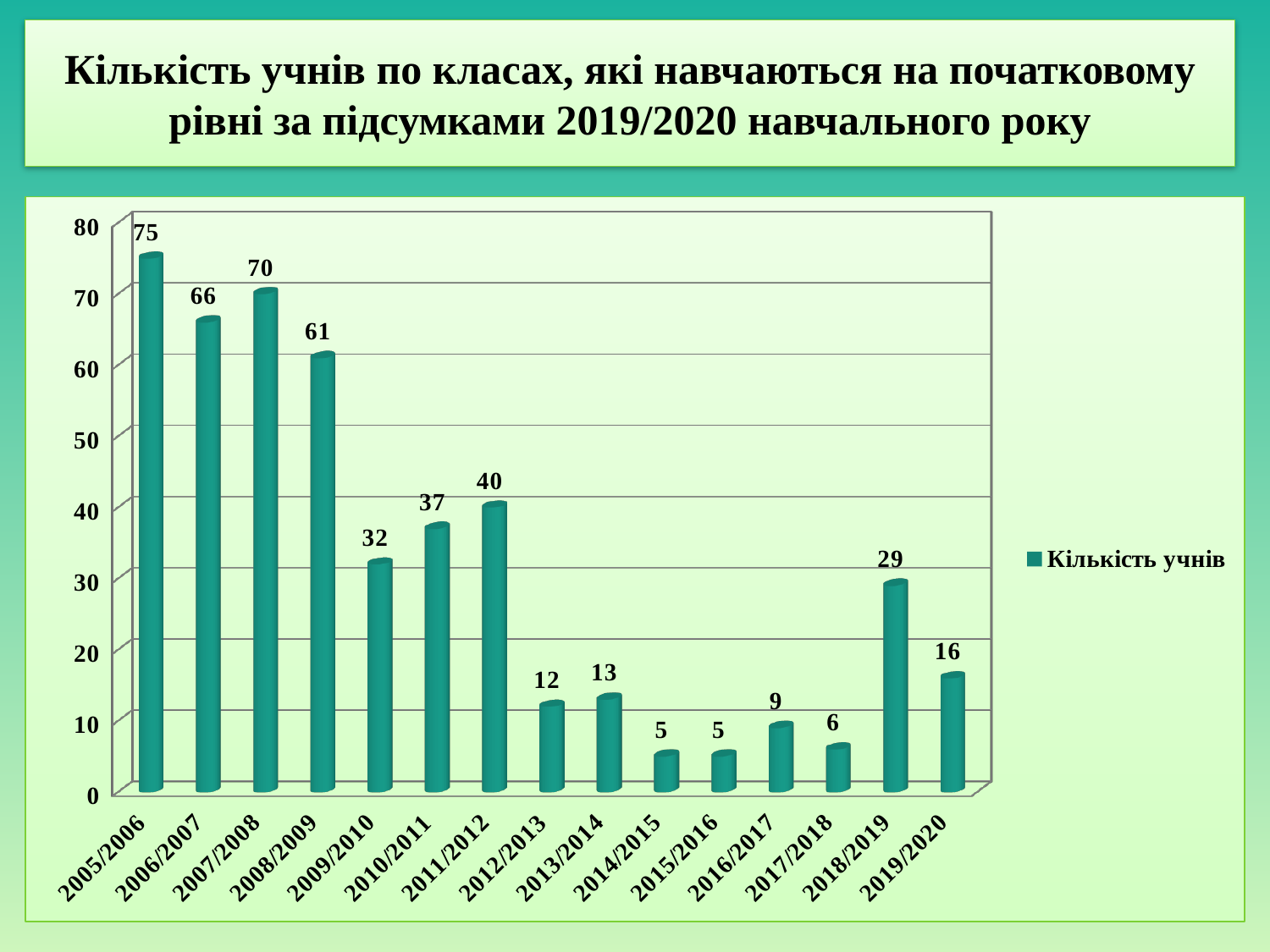
Which is larger, the value for 2010/2011 or the value for 2011/2012? 2011/2012 What kind of chart is shown on the slide? bar chart How many school years are shown on the x axis? 15 What is the value for 2019/2020? 16 What is the value for 2005/2006? 75 Is the value for 2009/2010 greater or less than 30? greater Which school year has the highest number of students? 2005/2006 How many series does the legend list? 1 What is the legend entry for the series? Кількість учнів What is the value for 2018/2019? 29 What is the difference between the values for 2007/2008 and 2008/2009? 9